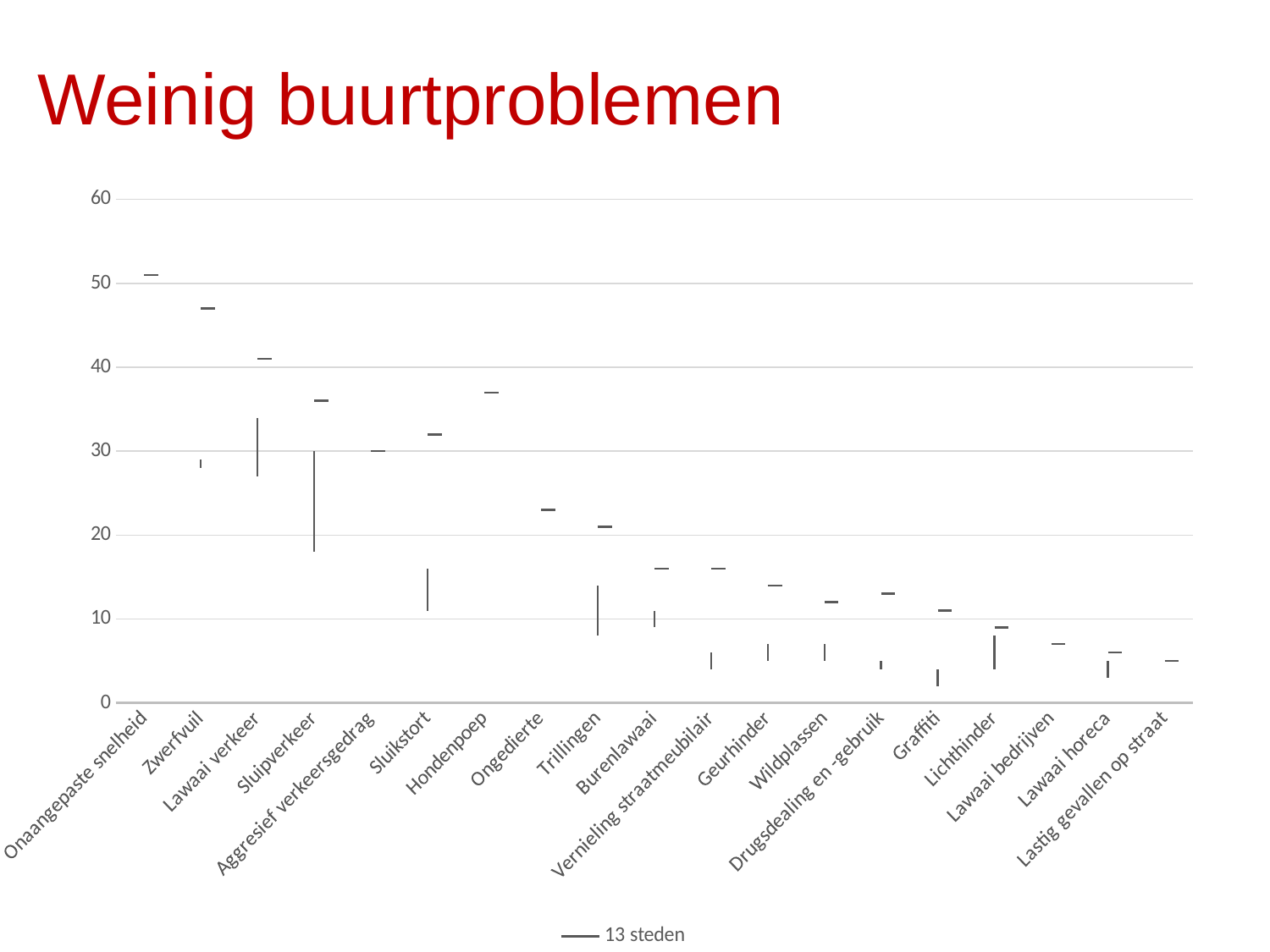
What is the title of the slide containing the chart? Weinig buurtproblemen Which is larger, the value for Zwerfvuil or the value for Hondenpoep? Zwerfvuil Do the values generally rise or fall moving from left to right along the x axis? fall Is the value for Lastig gevallen op straat greater or less than 10? less What is the series name shown in the chart legend? 13 steden Is the value for Zwerfvuil greater or less than 50? less How many categories are shown on the x axis of the chart? 19 Which category has the highest value in the chart? Onaangepaste snelheid Is the value for Burenlawaai greater or less than 20? less How many series does the chart legend list? 1